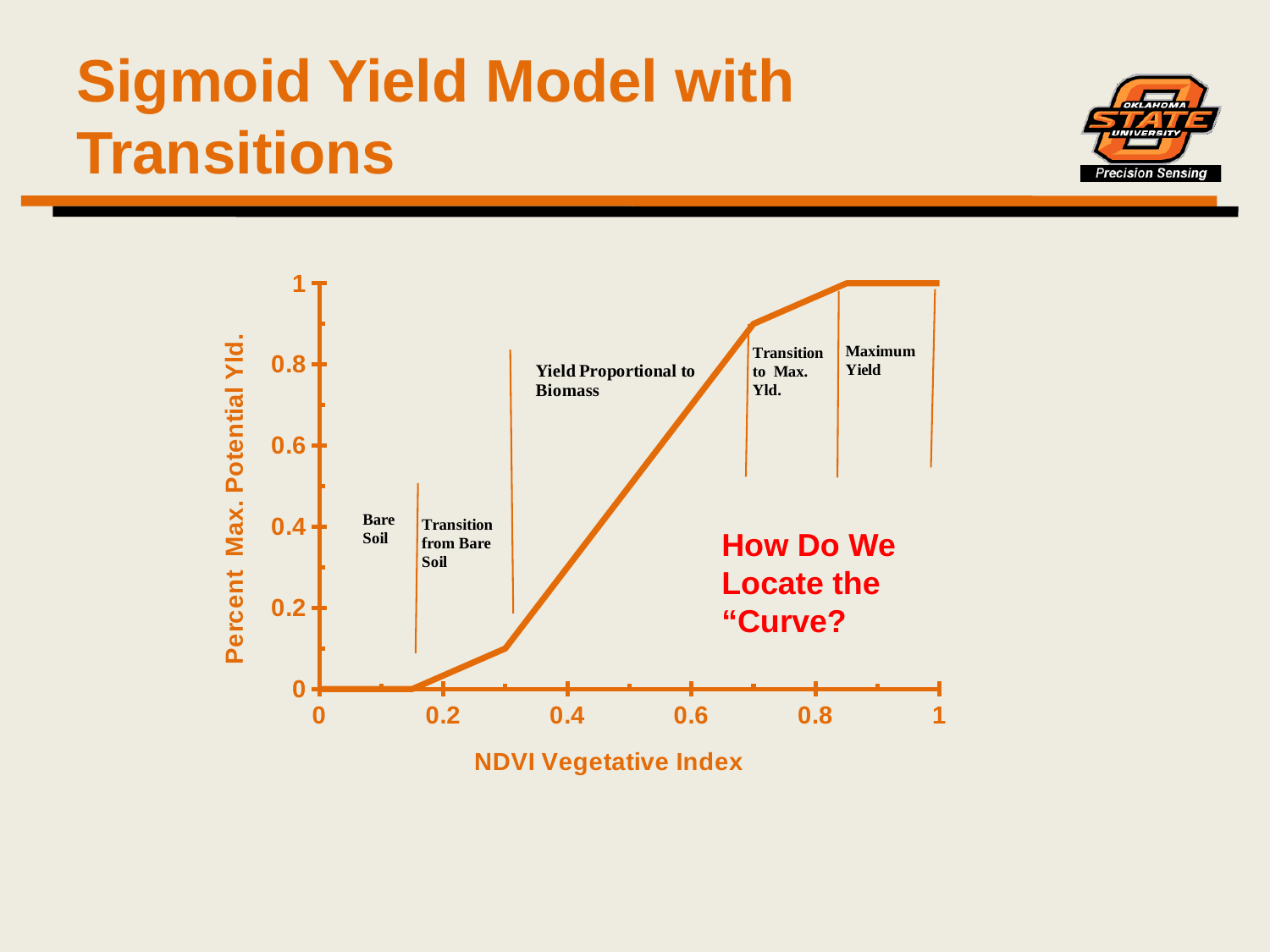
How many labeled regions (Bare Soil, Transition from Bare Soil, etc.) are marked along the curve? 5 What kind of chart is shown on the slide? line chart What is the label of the x axis? NDVI Vegetative Index What is the label of the y axis? Percent Max. Potential Yld. Which is larger, the Percent Max. Potential Yld. at an NDVI of 0.4 or at an NDVI of 0.6? 0.6 Is the value of Percent Max. Potential Yld. at an NDVI of 0.4 greater or less than 0.6? less Do the values of the line rise or fall as NDVI increases along the x axis? rise Is the value of Percent Max. Potential Yld. at an NDVI of 0.2 greater or less than 0.2? less Is the value of Percent Max. Potential Yld. at an NDVI of 0.6 greater or less than 0.6? greater What is the value of Percent Max. Potential Yld. at an NDVI of 0? 0 What is the value of Percent Max. Potential Yld. at an NDVI of 1? 1